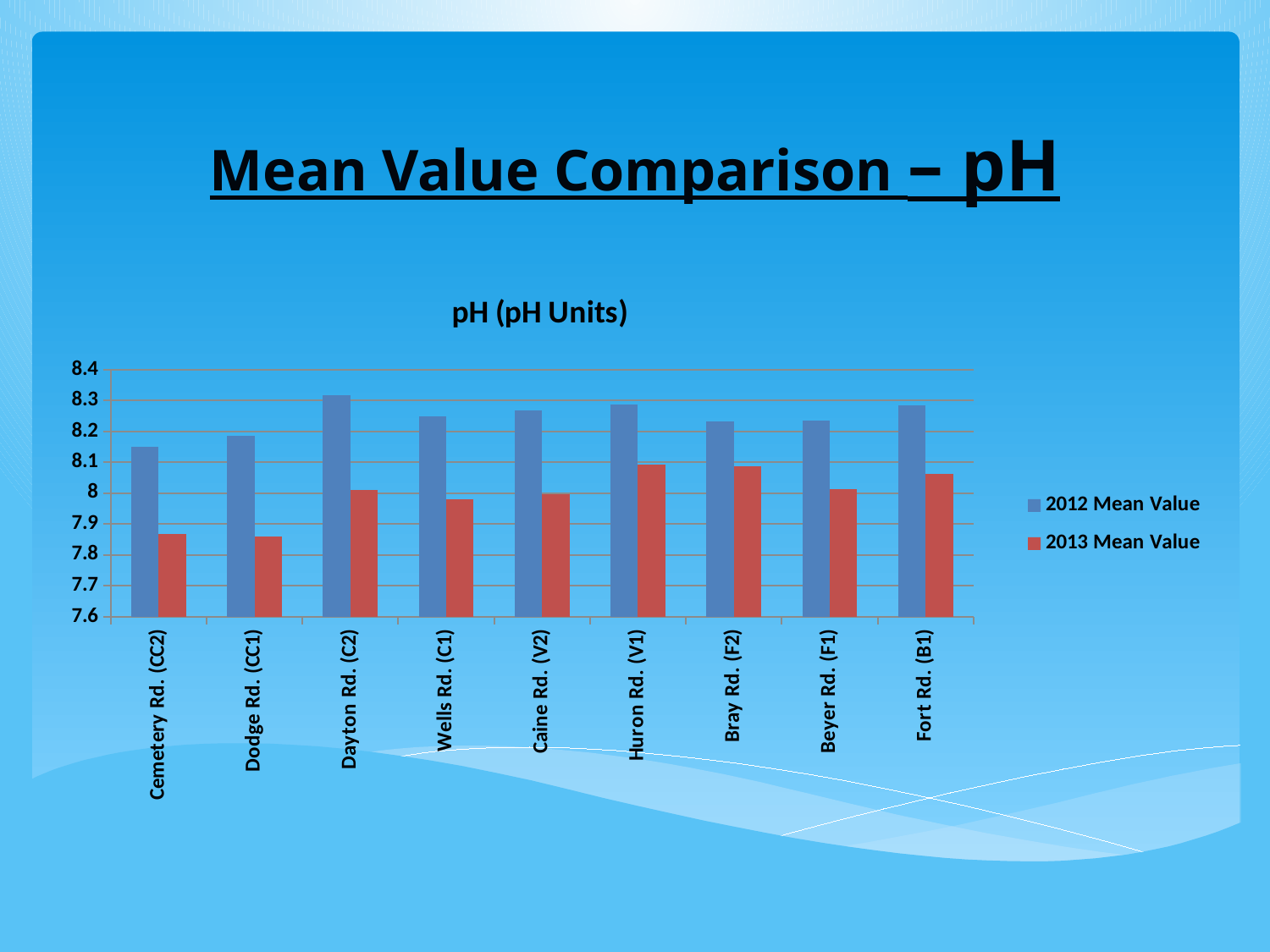
How many sites (categories) are shown on the x axis? 9 Which site has the lowest 2012 Mean Value? Cemetery Rd. (CC2) How many series does the legend list? 2 Which is larger: the 2012 Mean Value for Dayton Rd. (C2) or for Cemetery Rd. (CC2)? Dayton Rd. (C2) What kind of chart is shown on the slide? bar chart Is the 2012 Mean Value for Dayton Rd. (C2) greater or less than 8.3? greater Which site has the highest 2012 Mean Value? Dayton Rd. (C2) What is the title shown above the chart's plot area? pH (pH Units) Is the 2013 Mean Value for Cemetery Rd. (CC2) greater or less than 7.9? less Is the 2013 Mean Value for Huron Rd. (V1) greater or less than 8? greater For Fort Rd. (B1), which is larger: the 2012 Mean Value or the 2013 Mean Value? 2012 Mean Value